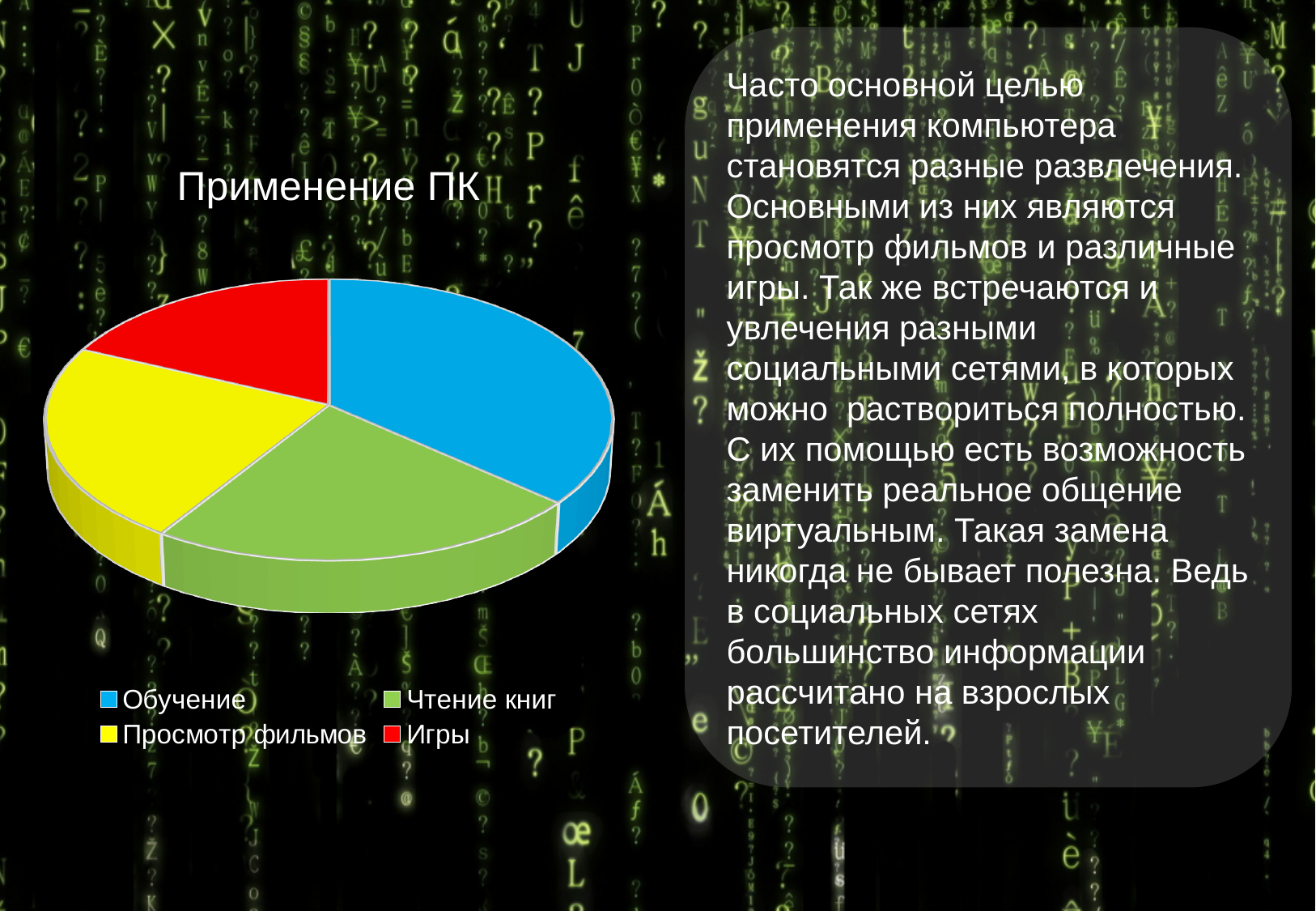
Which slice is larger: Просмотр фильмов or Игры? Просмотр фильмов Which slice is larger: Чтение книг or Игры? Чтение книг Which slice is larger: Обучение or Просмотр фильмов? Обучение What is the title of the pie chart? Применение ПК How many categories (slices) does the pie chart have? 4 Which category has the smallest slice in the pie chart? Игры Which category is represented by the red slice of the pie chart? Игры What kind of chart is shown on the slide? pie chart